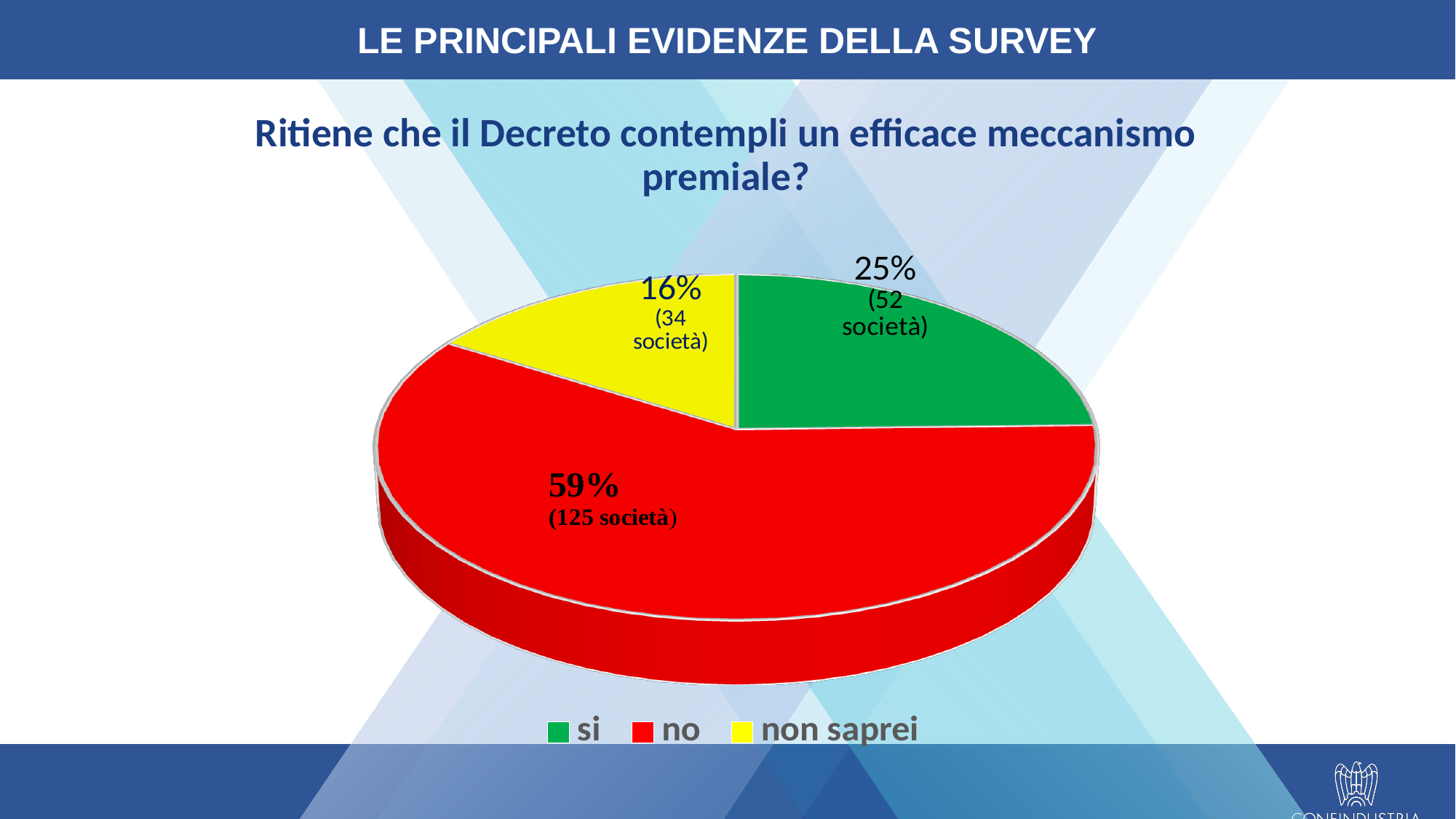
Which answer has the smallest share of the pie? non saprei What percentage of respondents answered "non saprei"? 16% How many companies answered "no"? 125 società How many companies answered "si"? 52 società What percentage of respondents answered "si"? 25% How many companies answered "non saprei"? 34 società What kind of chart is shown on the slide? pie chart Which answer has the largest share of the pie? no What percentage of respondents answered "no"? 59% Which colour represents the "non saprei" answer? yellow What is the difference in percentage points between the "no" and "si" slices? 34 How many categories does the legend list? 3